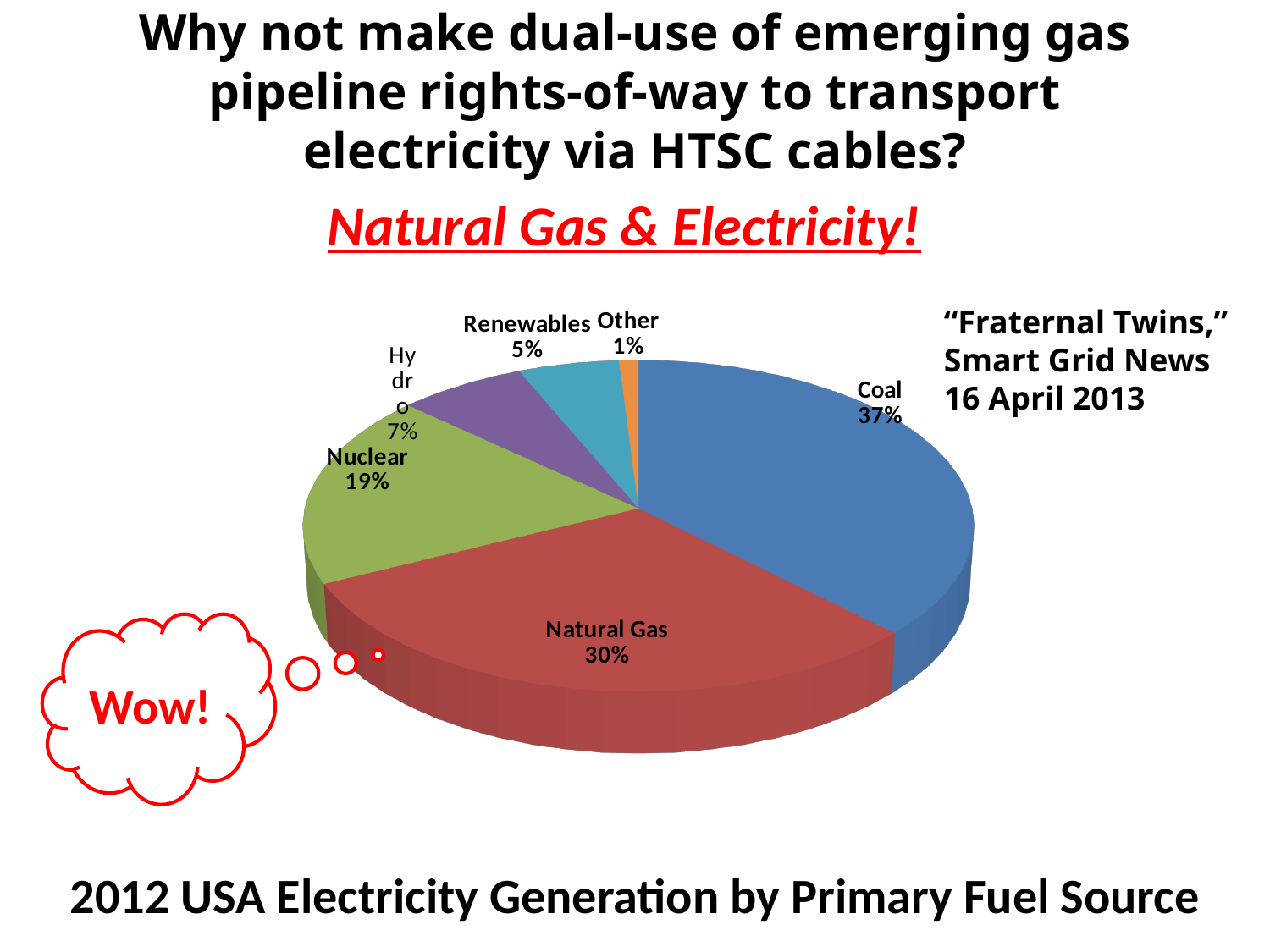
What share of 2012 USA electricity generation came from Nuclear? 19% What share of 2012 USA electricity generation came from Coal? 37% Which has a larger share, Nuclear or Hydro? Nuclear How many fuel source categories are shown in the pie chart? 6 What share of 2012 USA electricity generation came from Hydro? 7% What kind of chart is shown on the slide? Pie chart Which fuel source has the smallest share of the pie? Other What share of 2012 USA electricity generation came from Natural Gas? 30% How many percentage points larger is Coal's share than Natural Gas's share? 7 Which fuel source has the largest share of the pie? Coal What is the title of the chart at the bottom of the slide? 2012 USA Electricity Generation by Primary Fuel Source What share of 2012 USA electricity generation came from Renewables? 5%